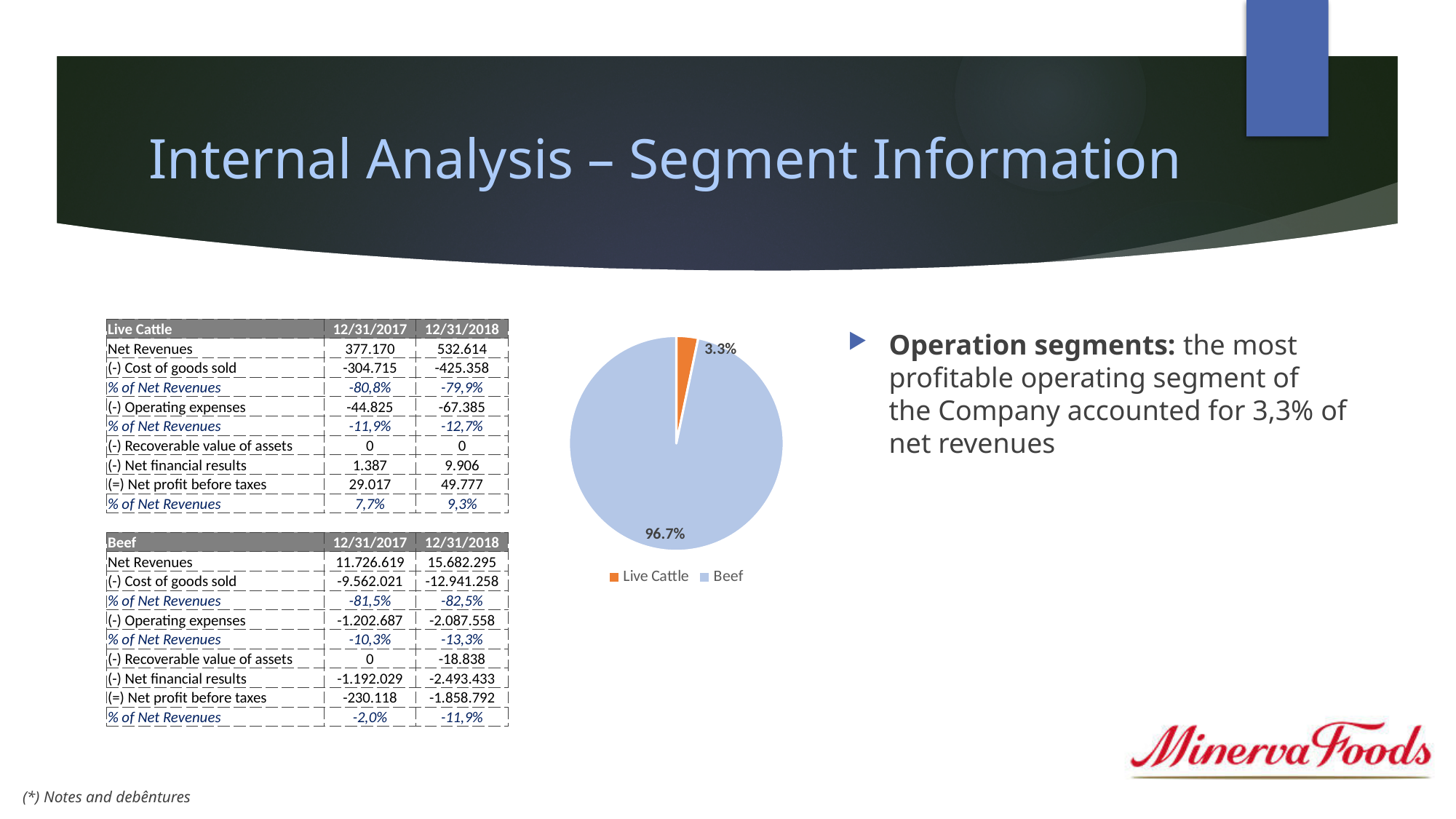
Which segment has the largest slice of the pie? Beef Which segment has the smallest slice of the pie? Live Cattle What share of the pie does Beef represent? 96.7% How many slices does the pie chart have? 2 Which is larger in the pie chart, the Live Cattle slice or the Beef slice? Beef How many entries does the legend of the pie chart list? 2 What colour is the Live Cattle slice in the pie chart? orange What share of the pie does Live Cattle represent? 3.3% What kind of chart is shown on the slide? pie chart What is the difference in percentage points between the Beef slice and the Live Cattle slice? 93.4 What colour is the Beef slice in the pie chart? light blue